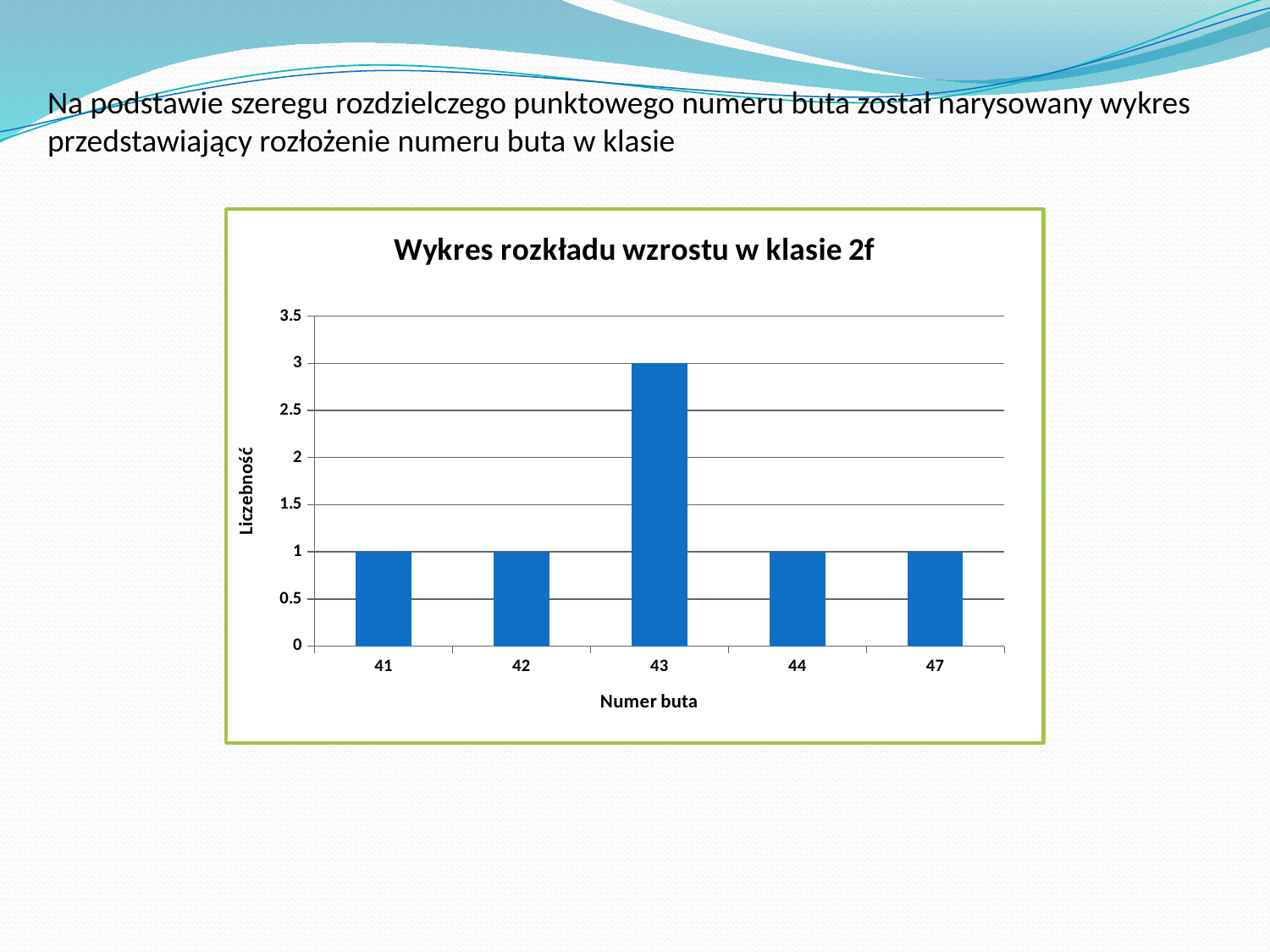
What type of chart is shown on the slide? bar chart What is the title of the chart? Wykres rozkładu wzrostu w klasie 2f Which has a larger value, shoe size 43 or shoe size 44? 43 What is the value (Liczebność) for shoe size 41? 1 Is the value for shoe size 43 greater or less than 2? greater What is the value (Liczebność) for shoe size 43? 3 What is the value (Liczebność) for shoe size 47? 1 Is the value for shoe size 44 greater or less than 2? less How many shoe-size categories are shown on the x axis? 5 What is the label of the x axis? Numer buta What is the difference between the values for shoe size 43 and shoe size 42? 2 Which shoe size has the highest Liczebność? 43